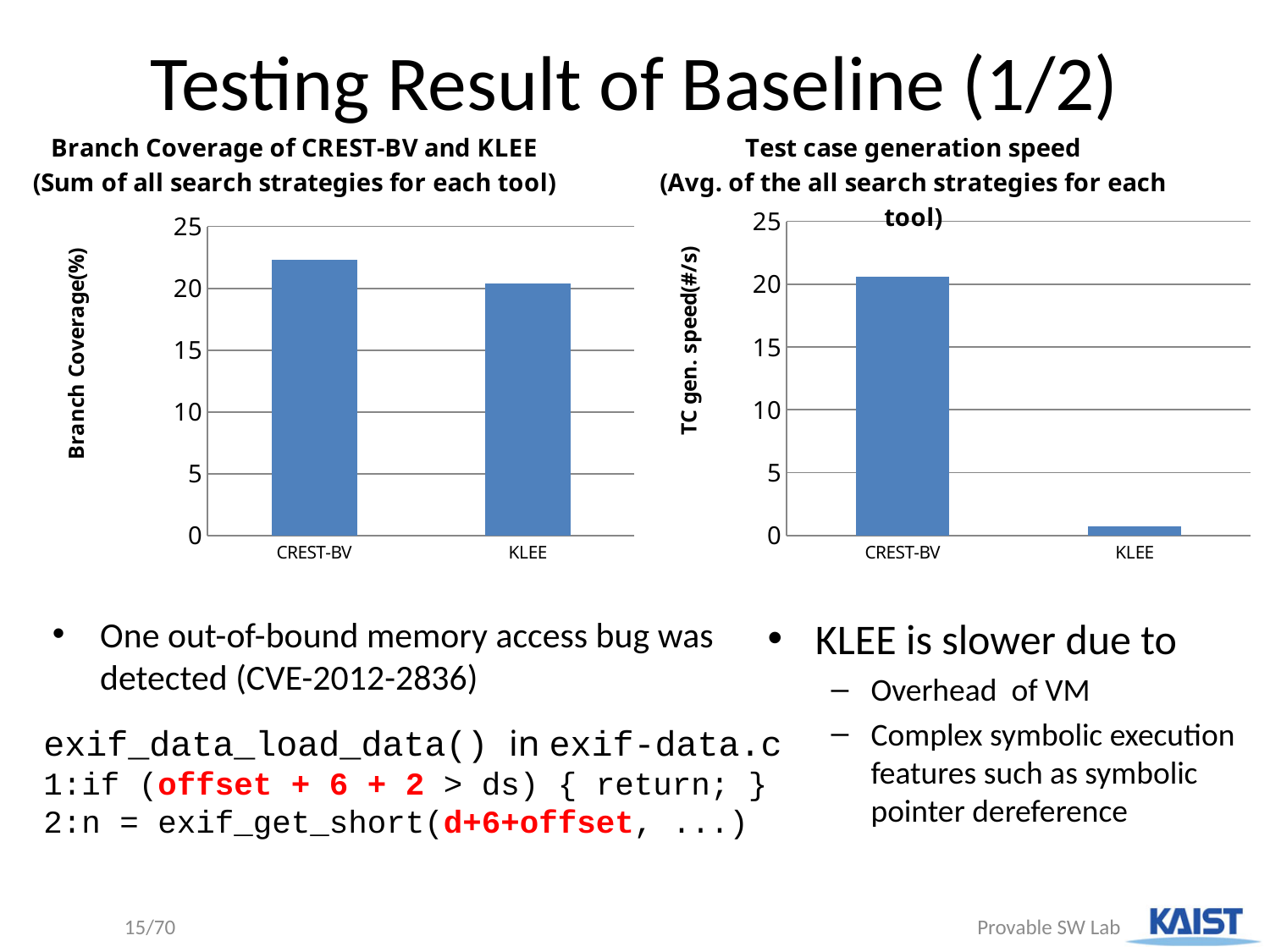
In the 'Test case generation speed' chart, which tool has the lowest test case generation speed? KLEE In the 'Test case generation speed' chart, what is the y-axis label? TC gen. speed(#/s) In the 'Test case generation speed' chart, which is larger, the value for CREST-BV or the value for KLEE? CREST-BV In the 'Branch Coverage of CREST-BV and KLEE' chart, what is the y-axis label? Branch Coverage(%) In the 'Test case generation speed' chart, is the value for KLEE greater or less than 5? less In the 'Branch Coverage of CREST-BV and KLEE' chart, is the value for CREST-BV greater or less than 25? less In the 'Test case generation speed' chart, how many bars are plotted? 2 In the 'Branch Coverage of CREST-BV and KLEE' chart, how many categories are plotted? 2 In the 'Branch Coverage of CREST-BV and KLEE' chart, which tool has the higher branch coverage? CREST-BV In the 'Branch Coverage of CREST-BV and KLEE' chart, what kind of chart is shown? bar chart In the 'Test case generation speed' chart, is the value for CREST-BV greater or less than 20? greater